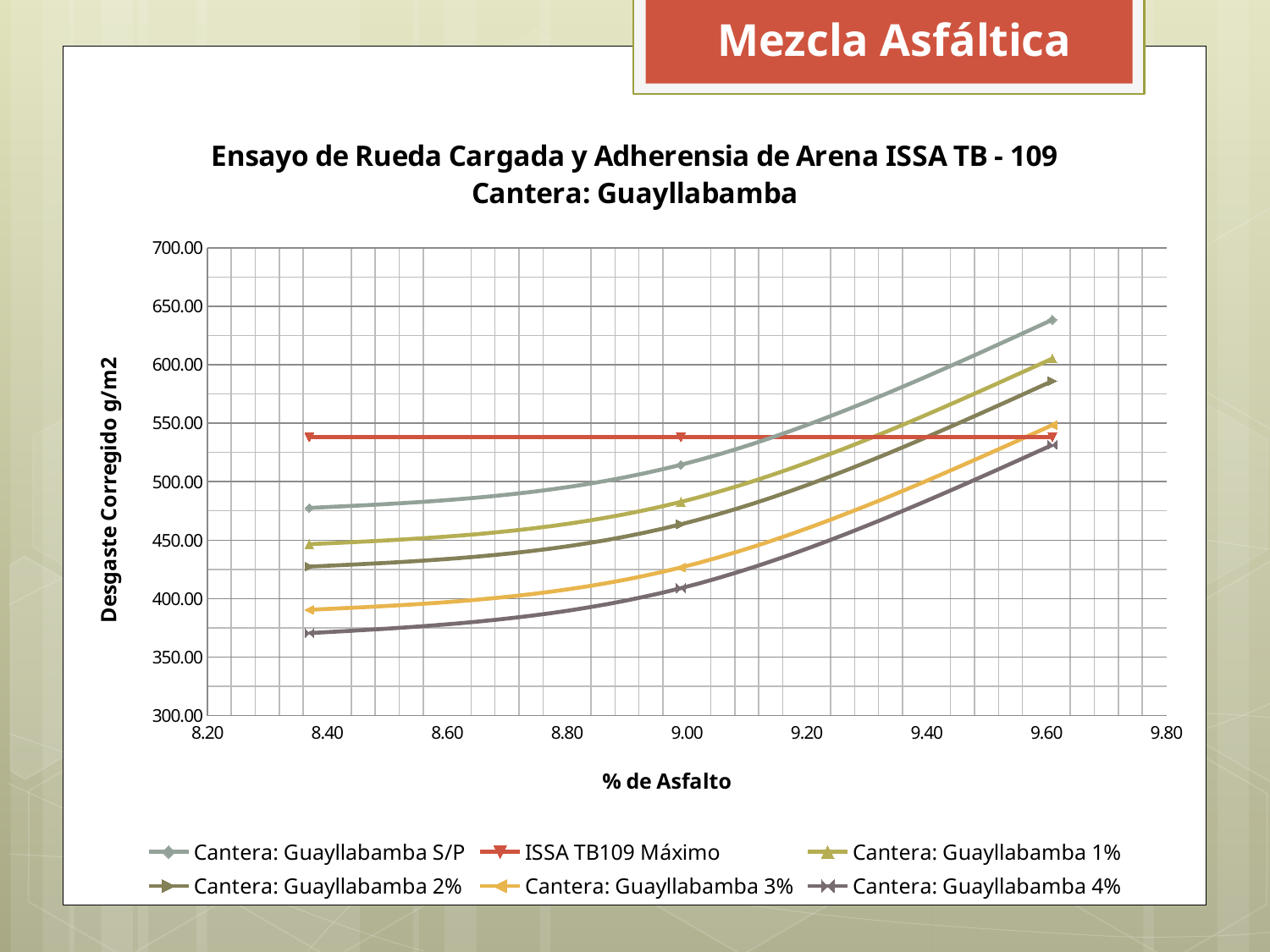
How many data points does each Cantera: Guayllabamba series have? 3 Is the value for Cantera: Guayllabamba 4% at its leftmost point greater or less than 400.00? less How many series does the legend list? 6 At the rightmost point, which series is higher: Cantera: Guayllabamba S/P or Cantera: Guayllabamba 4%? Cantera: Guayllabamba S/P What kind of chart is shown on the slide? line chart What is the title of the chart? Ensayo de Rueda Cargada y Adherensia de Arena ISSA TB - 109 Cantera: Guayllabamba Do the values for Cantera: Guayllabamba 3% rise or fall as % de Asfalto increases? rise Is the value for Cantera: Guayllabamba S/P at its rightmost point greater or less than 600.00? greater Does the ISSA TB109 Máximo line rise, fall or stay flat as % de Asfalto increases? stay flat What is the label of the x axis? % de Asfalto Which series has the lowest value at the leftmost point? Cantera: Guayllabamba 4% Is the value of the ISSA TB109 Máximo line greater or less than 500.00? greater